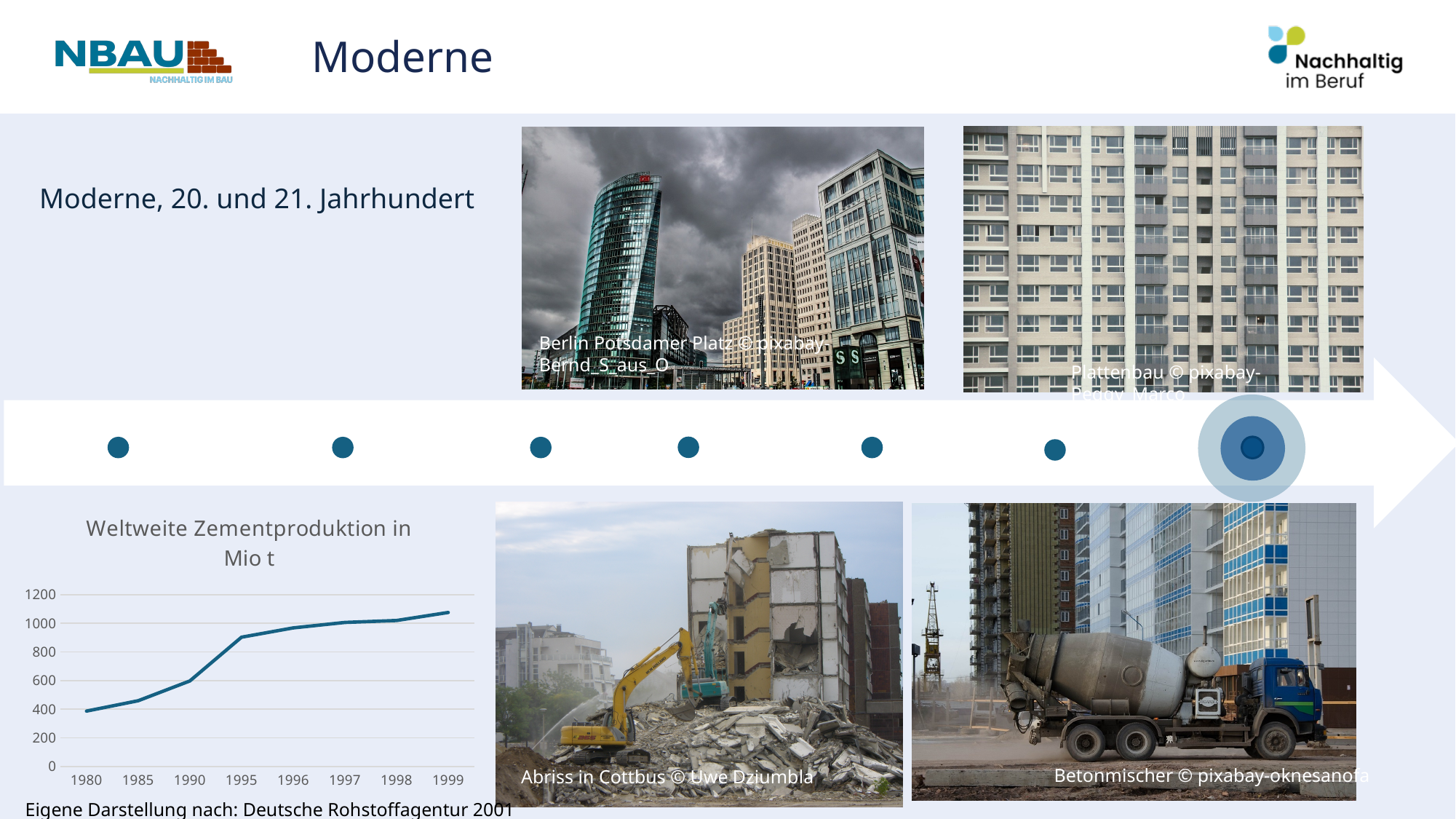
What is the highest tick value shown on the y axis of the chart? 1200 Is the value for 1995 greater or less than 800? greater Is the value for 1999 greater or less than 1000? greater What is the title of the chart on the slide? Weltweite Zementproduktion in Mio t Do the values in the chart rise or fall from 1980 to 1999? rise Is the value for 1990 greater or less than 400? greater Which year has the larger value, 1980 or 1999? 1999 Which year has the lowest value in the chart? 1980 What kind of chart is shown on the slide? line chart Which year has the highest value in the chart? 1999 How many years are plotted on the x axis of the chart? 8